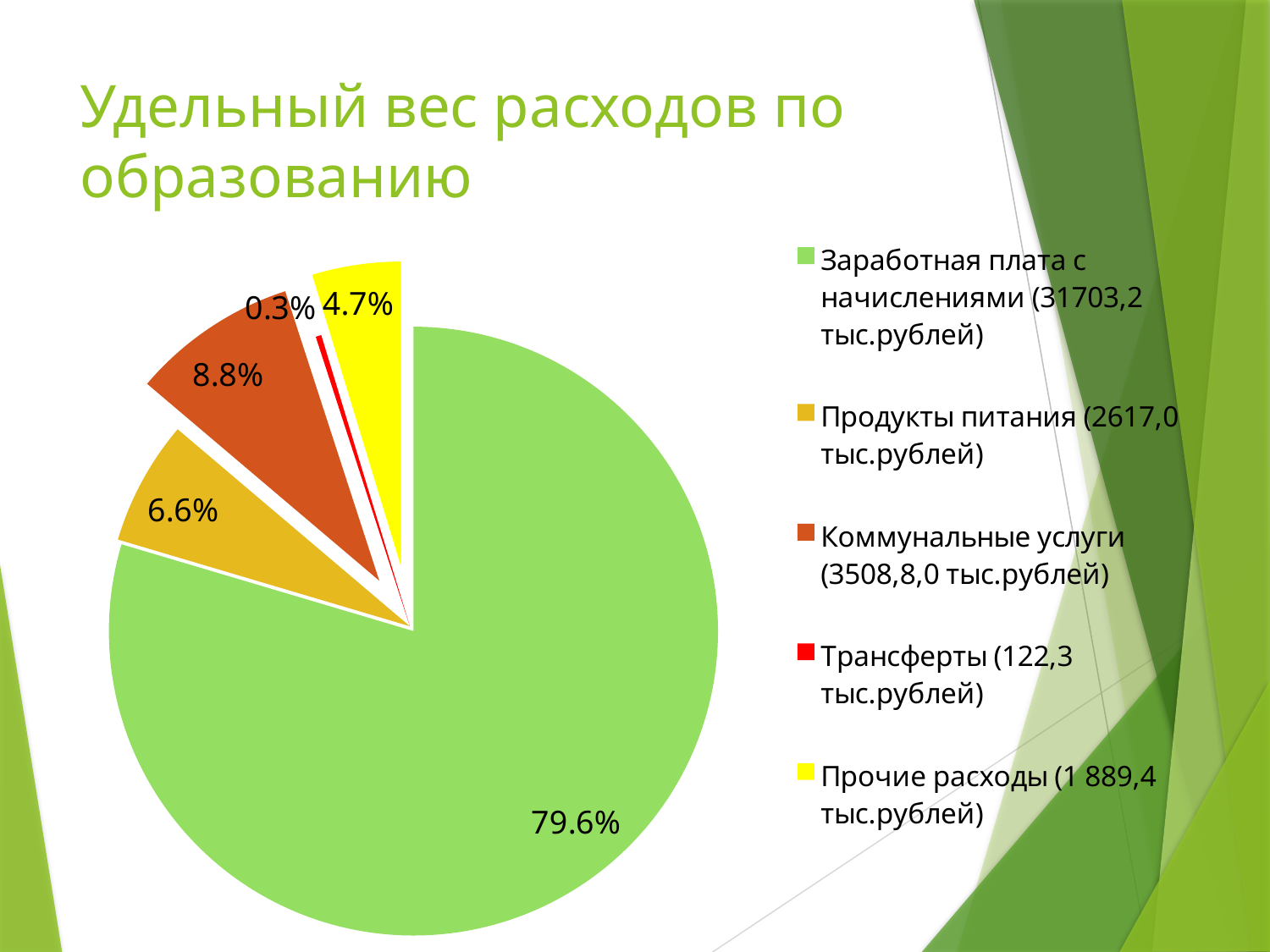
What share of the pie does "Прочие расходы" have? 4.7% What share of the pie does "Заработная плата с начислениями" have? 79.6% What share of the pie does "Продукты питания" have? 6.6% Which category has the largest slice of the pie? Заработная плата с начислениями Which is larger: the share for "Коммунальные услуги" or the share for "Продукты питания"? Коммунальные услуги Which category has the smallest slice of the pie? Трансферты What type of chart is shown on the slide? pie chart What is the title of the chart on the slide? Удельный вес расходов по образованию What is the difference in percentage points between the shares of "Коммунальные услуги" and "Прочие расходы"? 4.1 How many categories does the legend list? 5